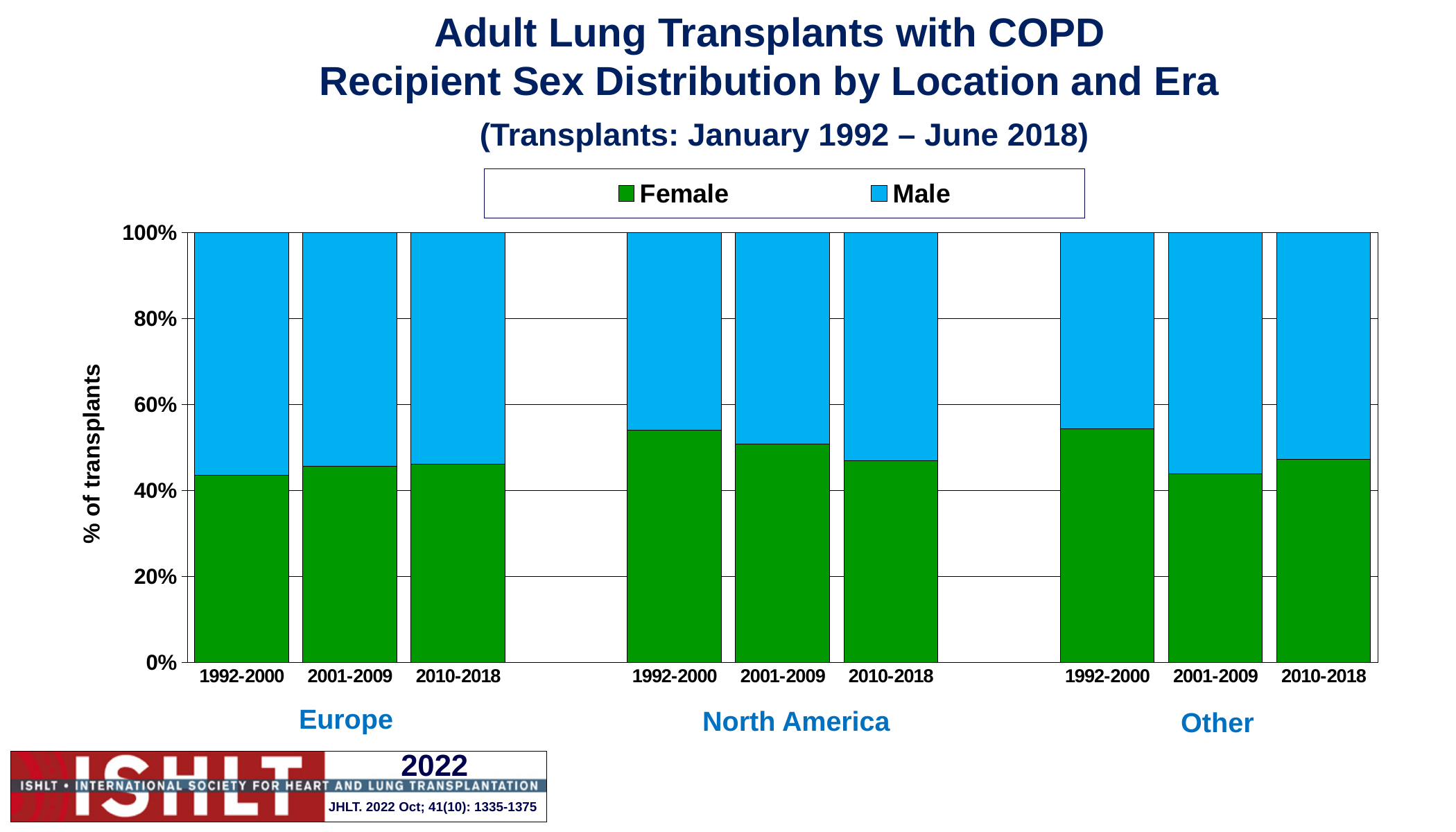
How many bars are plotted in the chart? 9 Which has the larger Female share: Europe 1992-2000 or North America 1992-2000? North America 1992-2000 What kind of chart is shown on the slide? Stacked bar chart Is the Female share for Europe 1992-2000 greater or less than 40%? greater Is the Female share for Other 2001-2009 greater or less than 50%? less How many series does the legend list? 2 Within North America, does the Female share rise or fall across the eras from 1992-2000 to 2010-2018? fall Is the Female share for North America 1992-2000 greater or less than 50%? greater What is the label on the y axis? % of transplants How many location groups are shown along the x axis? 3 Within the Other group, which era has the lowest Female share? 2001-2009